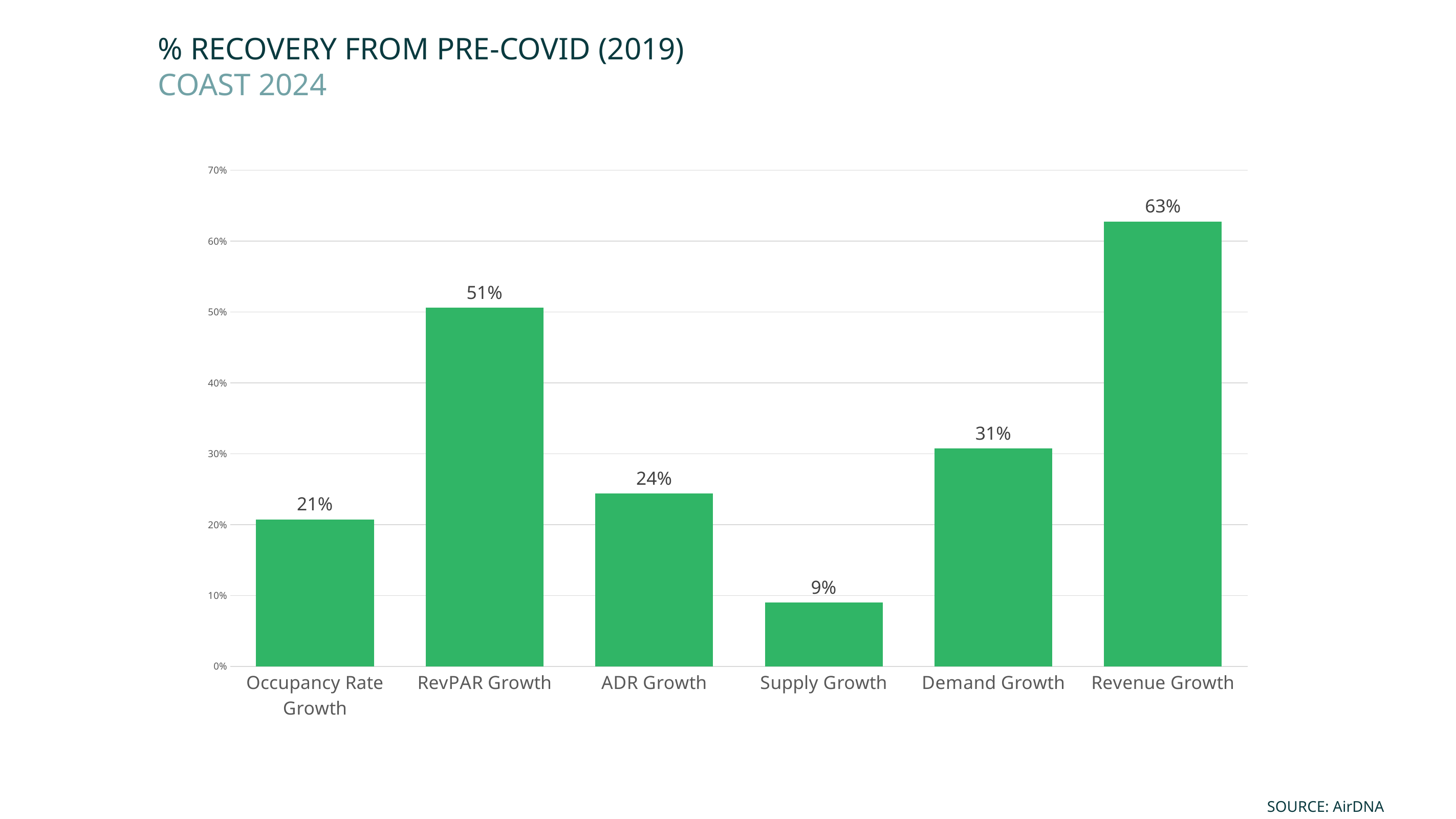
How many categories are shown on the chart? 6 Is the value for Demand Growth greater or less than 30%? greater What is the value for Demand Growth? 31% Which category has the highest value? Revenue Growth What is the value for Occupancy Rate Growth? 21% What is the value for RevPAR Growth? 51% What is the value for Supply Growth? 9% What is the difference between Demand Growth and ADR Growth? 7% Which is larger, ADR Growth or Occupancy Rate Growth? ADR Growth Which category has the lowest value? Supply Growth What kind of chart is shown on the slide? Bar chart What is the difference between Revenue Growth and RevPAR Growth? 12%